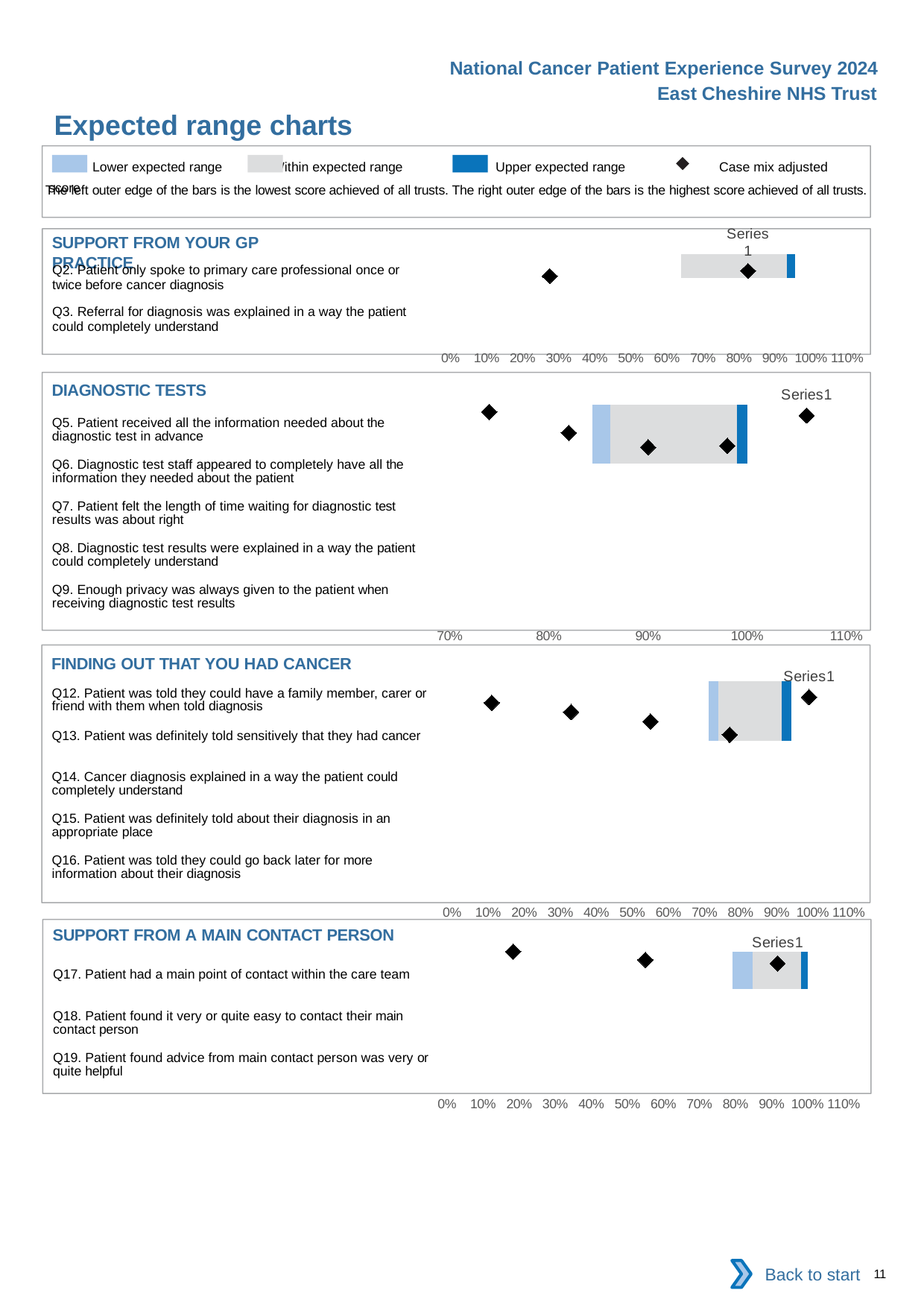
How many questions are listed in the 'DIAGNOSTIC TESTS' chart? 5 How many questions are listed in the 'FINDING OUT THAT YOU HAD CANCER' chart? 5 In the 'DIAGNOSTIC TESTS' chart, what is the lowest value shown on the x axis? 70% What is the title of the chart that lists Q12 to Q16? FINDING OUT THAT YOU HAD CANCER How many questions are listed in the 'SUPPORT FROM A MAIN CONTACT PERSON' chart? 3 What is the title of the chart that lists Q17, Q18 and Q19? SUPPORT FROM A MAIN CONTACT PERSON In the 'SUPPORT FROM A MAIN CONTACT PERSON' chart, what is the highest value shown on the x axis? 110% How many entries does the legend at the top of the slide list? 4